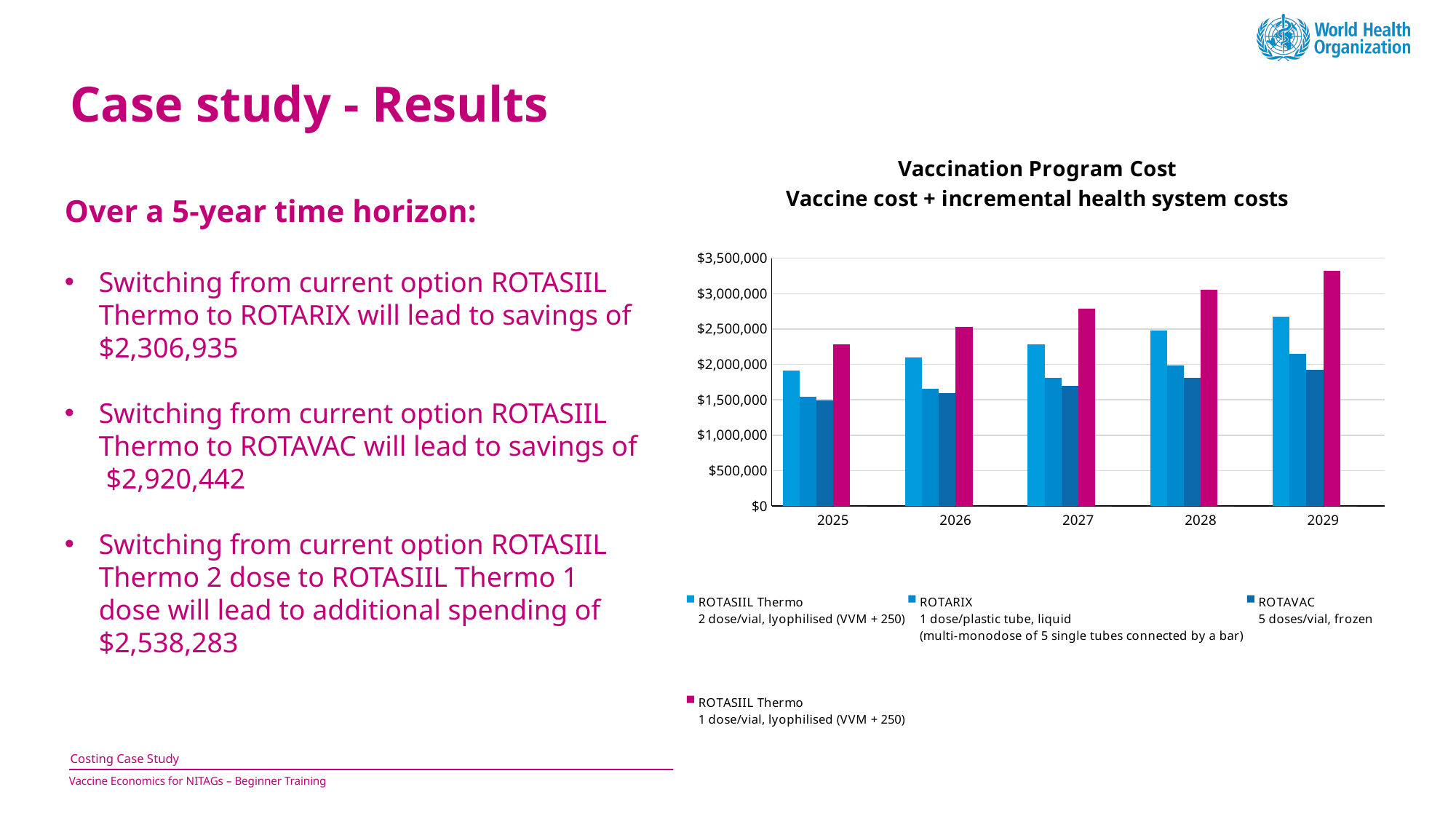
What kind of chart is shown on the slide? Bar chart Do the costs for ROTASIIL Thermo 1 dose/vial rise or fall from 2025 to 2029? rise How many series does the chart legend list? 4 In 2028, which is larger: the cost for ROTASIIL Thermo 2 dose/vial or for ROTARIX? ROTASIIL Thermo 2 dose/vial What colour represents ROTASIIL Thermo 1 dose/vial in the chart? Magenta Is the 2029 value for ROTASIIL Thermo 1 dose/vial greater or less than $3,000,000? greater Is the 2025 value for ROTASIIL Thermo 2 dose/vial greater or less than $2,000,000? less How many years are shown on the x axis of the chart? 5 Which vaccine option has the highest cost in 2029? ROTASIIL Thermo 1 dose/vial, lyophilised (VVM + 250) What is the title of the chart? Vaccination Program Cost Vaccine cost + incremental health system costs Is the 2025 value for ROTASIIL Thermo 1 dose/vial greater or less than $2,000,000? greater Which vaccine option has the lowest cost in 2025? ROTAVAC 5 doses/vial, frozen